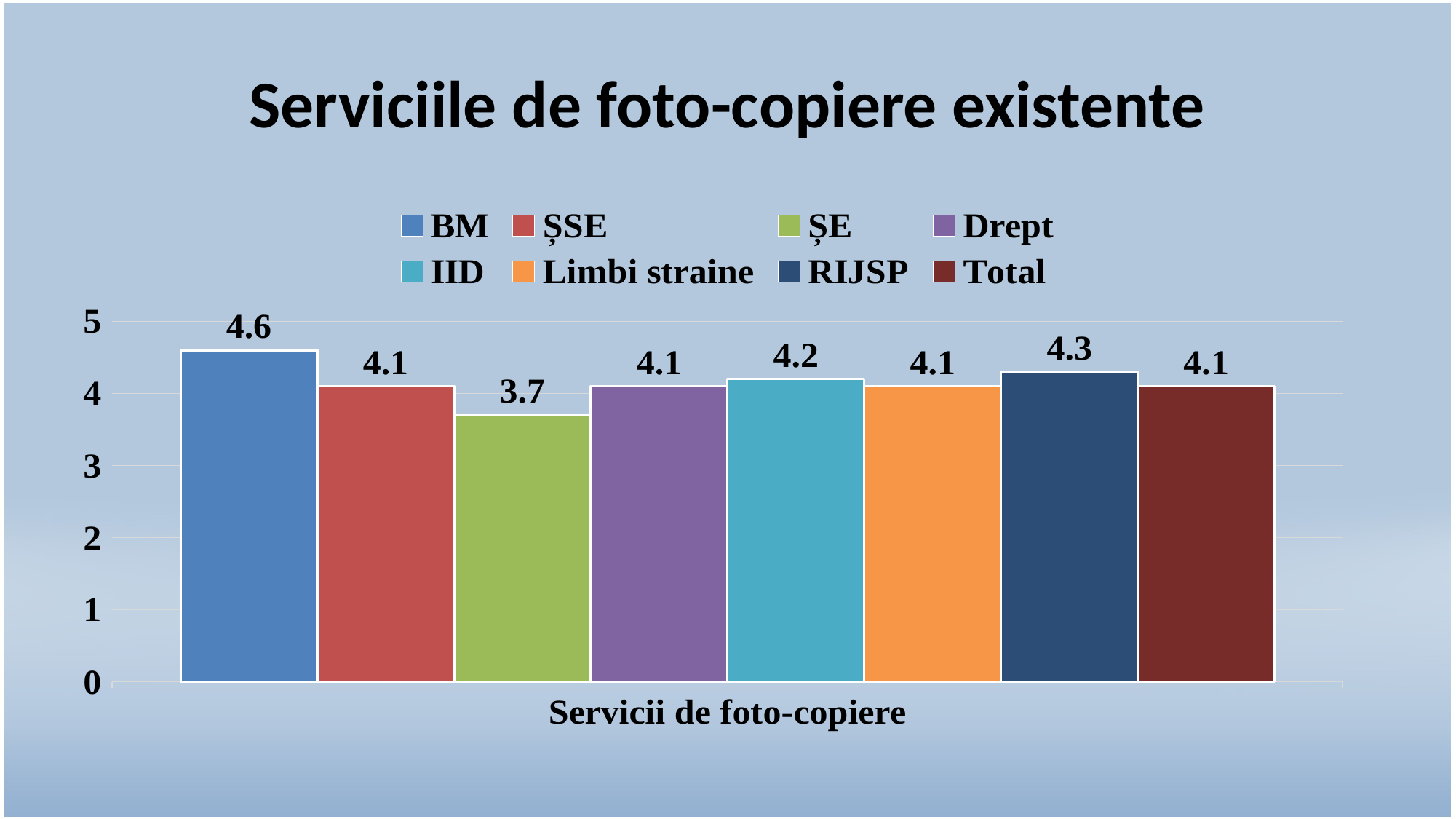
How many series does the legend list? 8 Which is larger, the value for RIJSP or the value for IID? RIJSP What is the value for RIJSP? 4.3 What is the value for BM? 4.6 What is the value for ȘE? 3.7 Which series has the lowest value? ȘE What is the difference between the values for BM and ȘE? 0.9 What kind of chart is shown on the slide? Bar chart What is the title of the chart? Serviciile de foto-copiere existente Which series has the highest value? BM What is the value for IID? 4.2 What is the value for Total? 4.1